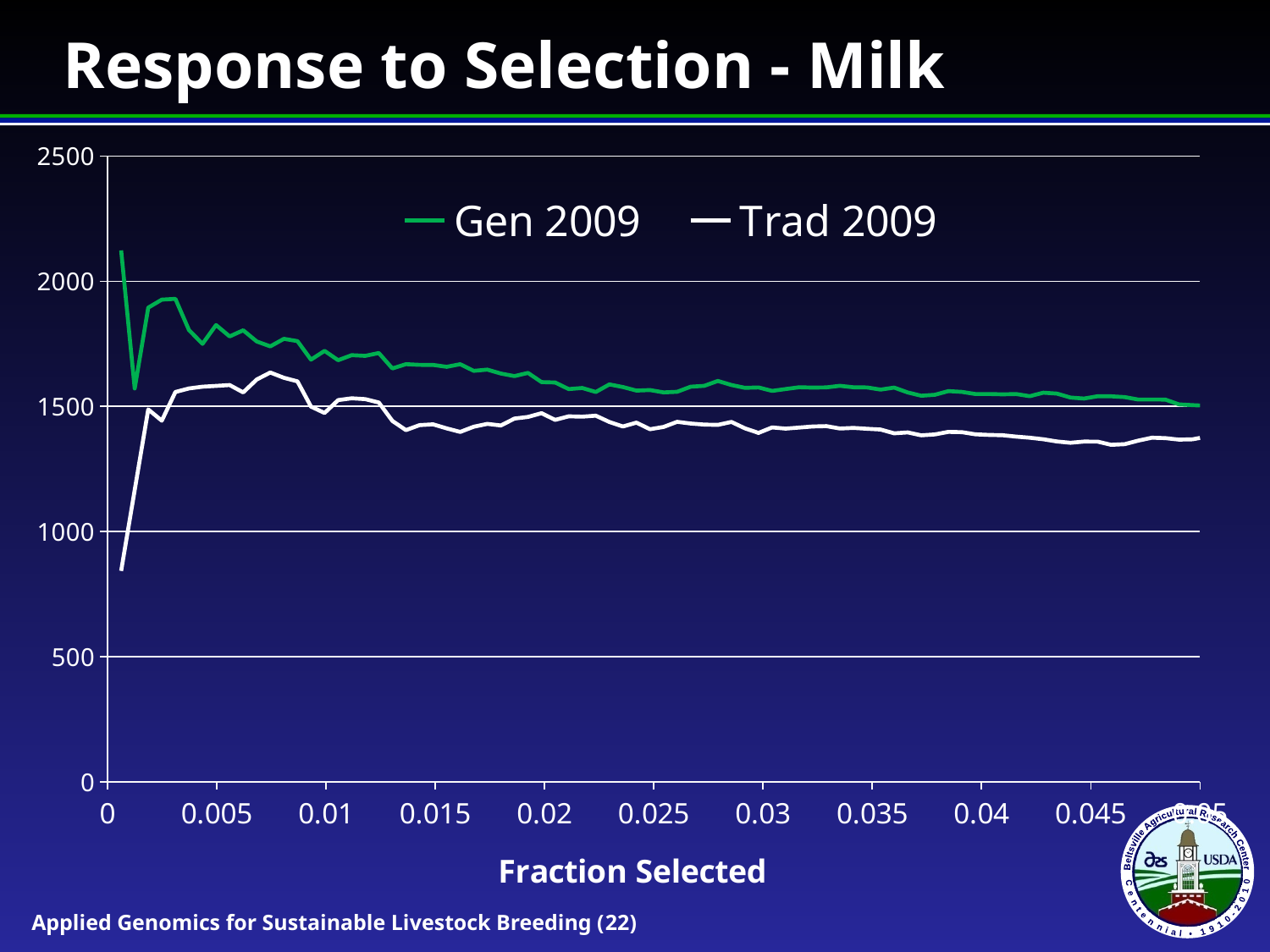
Is the value for Gen 2009 at a fraction selected of 0.02 greater or less than 1500? greater Does the Gen 2009 line generally rise or fall as the fraction selected increases from 0.01 to 0.05? fall How many series does the legend list? 2 Is the value for Trad 2009 at a fraction selected of 0.04 greater or less than 1500? less Is the value for Gen 2009 at a fraction selected of 0.005 greater or less than 2000? less What kind of chart is shown on the slide? line chart What is the title of the chart? Response to Selection - Milk Does the Trad 2009 line generally rise or fall as the fraction selected increases from 0.015 to 0.05? fall What is the label of the x axis? Fraction Selected At a fraction selected of 0.02, which series has the higher value, Gen 2009 or Trad 2009? Gen 2009